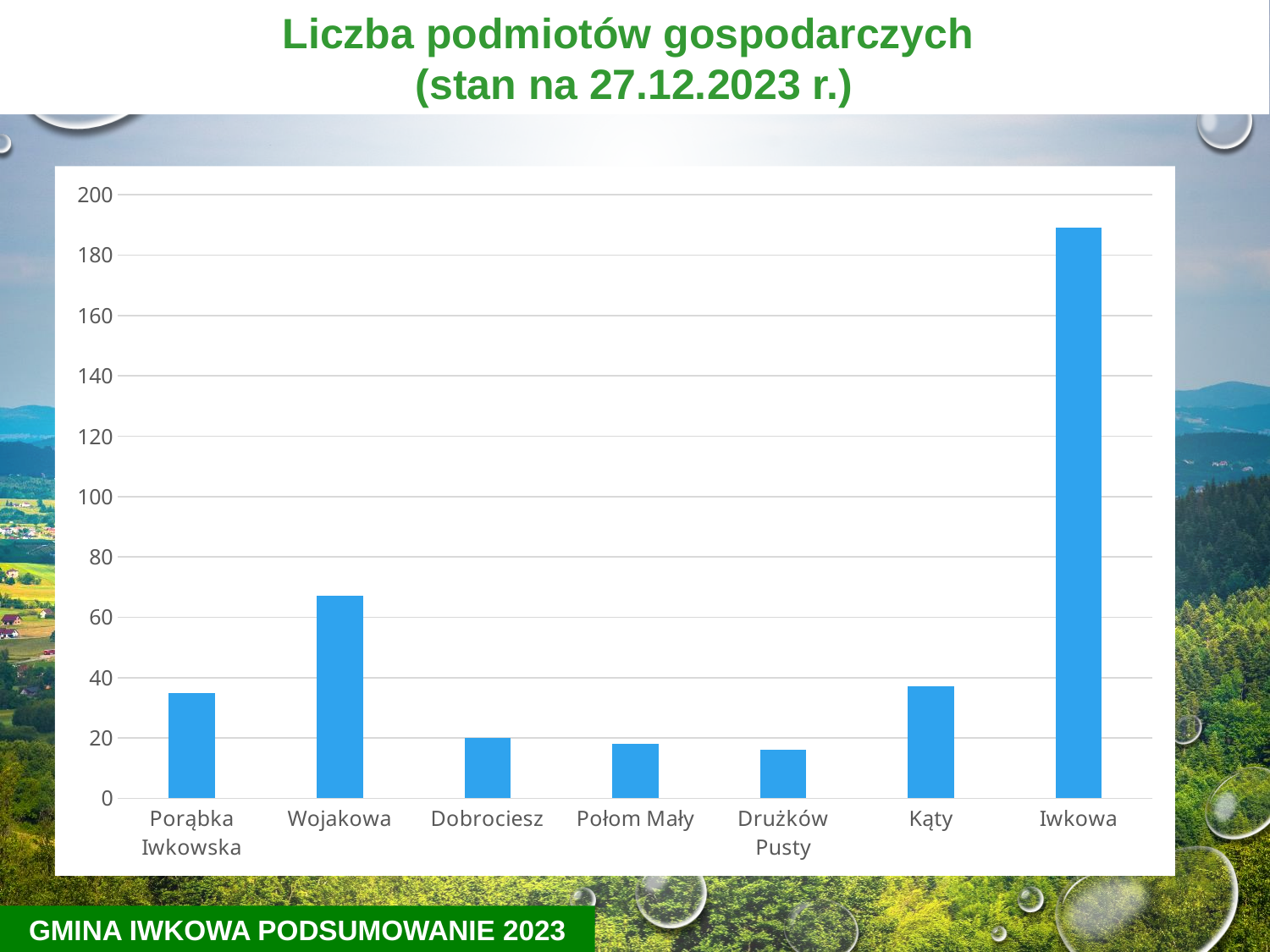
How many categories (localities) are shown on the x axis of the chart? 7 Is the value for Iwkowa greater or less than 180? greater Is the value for Porąbka Iwkowska greater or less than 40? less Is the value for Drużków Pusty greater or less than 20? less Which has a larger value, Iwkowa or Wojakowa? Iwkowa Which locality has the highest number of business entities in the chart? Iwkowa What is the title of the chart on the slide? Liczba podmiotów gospodarczych (stan na 27.12.2023 r.) What kind of chart is shown on the slide? bar chart Which has a larger value, Wojakowa or Kąty? Wojakowa